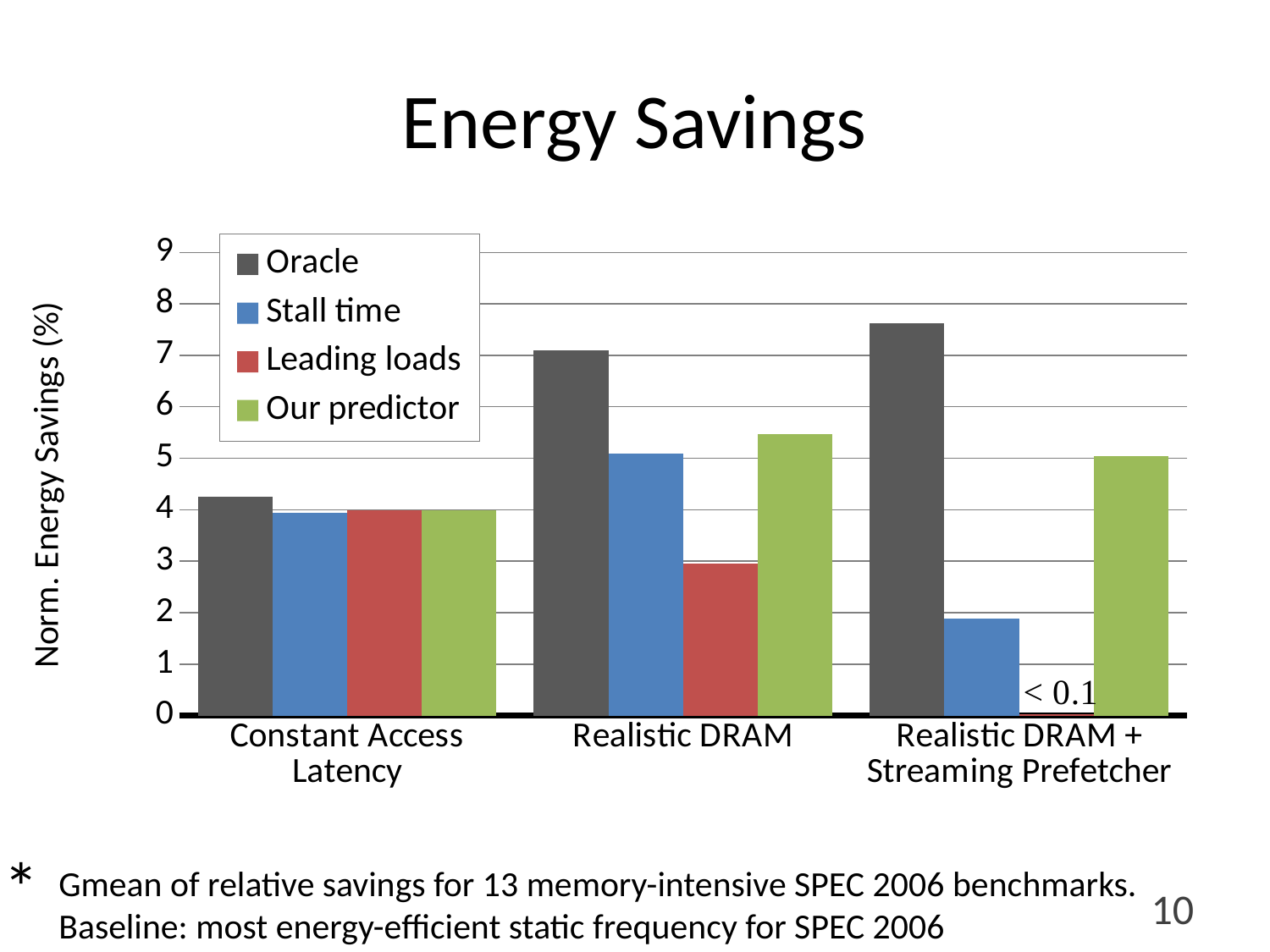
Which series has the highest value for Realistic DRAM? Oracle How many categories are shown along the x axis? 3 What kind of chart is shown on the slide? bar chart How many series does the legend list? 4 Is the Stall time value for Realistic DRAM + Streaming Prefetcher greater or less than 3? less Is the Oracle value for Realistic DRAM greater or less than 6? greater For Realistic DRAM, which is larger: Stall time or Our predictor? Our predictor Does the Oracle value rise or fall from Constant Access Latency to Realistic DRAM + Streaming Prefetcher? rise Which series has the lowest value for Realistic DRAM + Streaming Prefetcher? Leading loads For Realistic DRAM, which is larger: Stall time or Leading loads? Stall time What is the label on the y axis? Norm. Energy Savings (%) Is the Our predictor value for Realistic DRAM greater or less than 5? greater